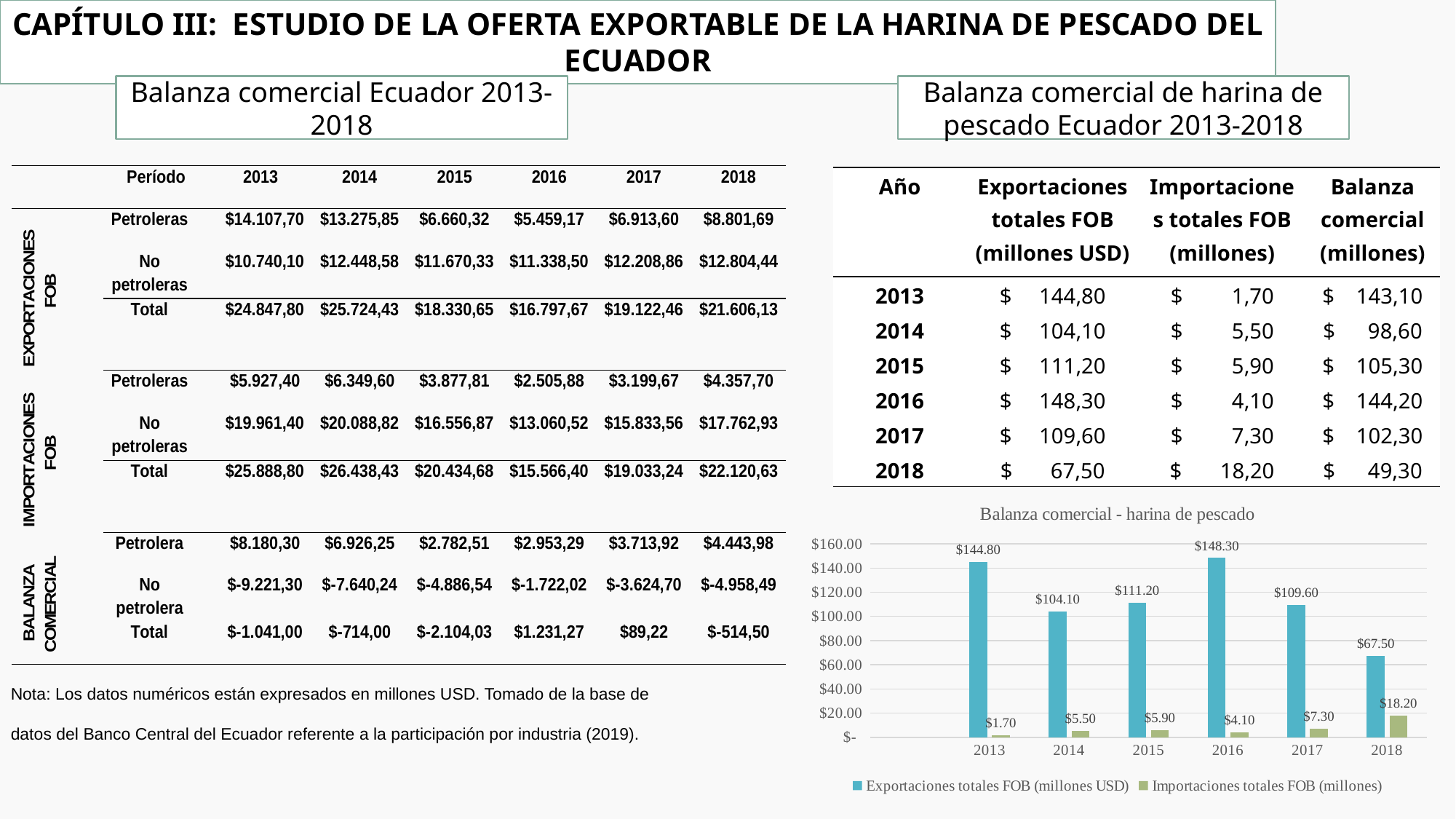
In the chart 'Balanza comercial - harina de pescado', which year has the lowest Importaciones totales FOB? 2013 In the chart 'Balanza comercial - harina de pescado', which colour represents Importaciones totales FOB (millones)? Green In the chart 'Balanza comercial - harina de pescado', which year has the highest Exportaciones totales FOB? 2016 In the chart 'Balanza comercial - harina de pescado', is the Exportaciones totales FOB value for 2018 greater or less than $80.00? less In the chart 'Balanza comercial - harina de pescado', what is the value of Importaciones totales FOB for 2018? $18.20 In the chart 'Balanza comercial - harina de pescado', how many years are shown on the x axis? 6 In the chart 'Balanza comercial - harina de pescado', how many series does the legend list? 2 In the chart 'Balanza comercial - harina de pescado', what is the value of Exportaciones totales FOB for 2016? $148.30 In the chart 'Balanza comercial - harina de pescado', is Exportaciones totales FOB higher in 2015 or in 2017? 2015 What type of chart is shown under the title 'Balanza comercial - harina de pescado'? Bar chart In the chart 'Balanza comercial - harina de pescado', what is the value of Exportaciones totales FOB for 2014? $104.10 In the chart 'Balanza comercial - harina de pescado', what is the difference between Exportaciones totales FOB in 2016 and in 2018? $80.80